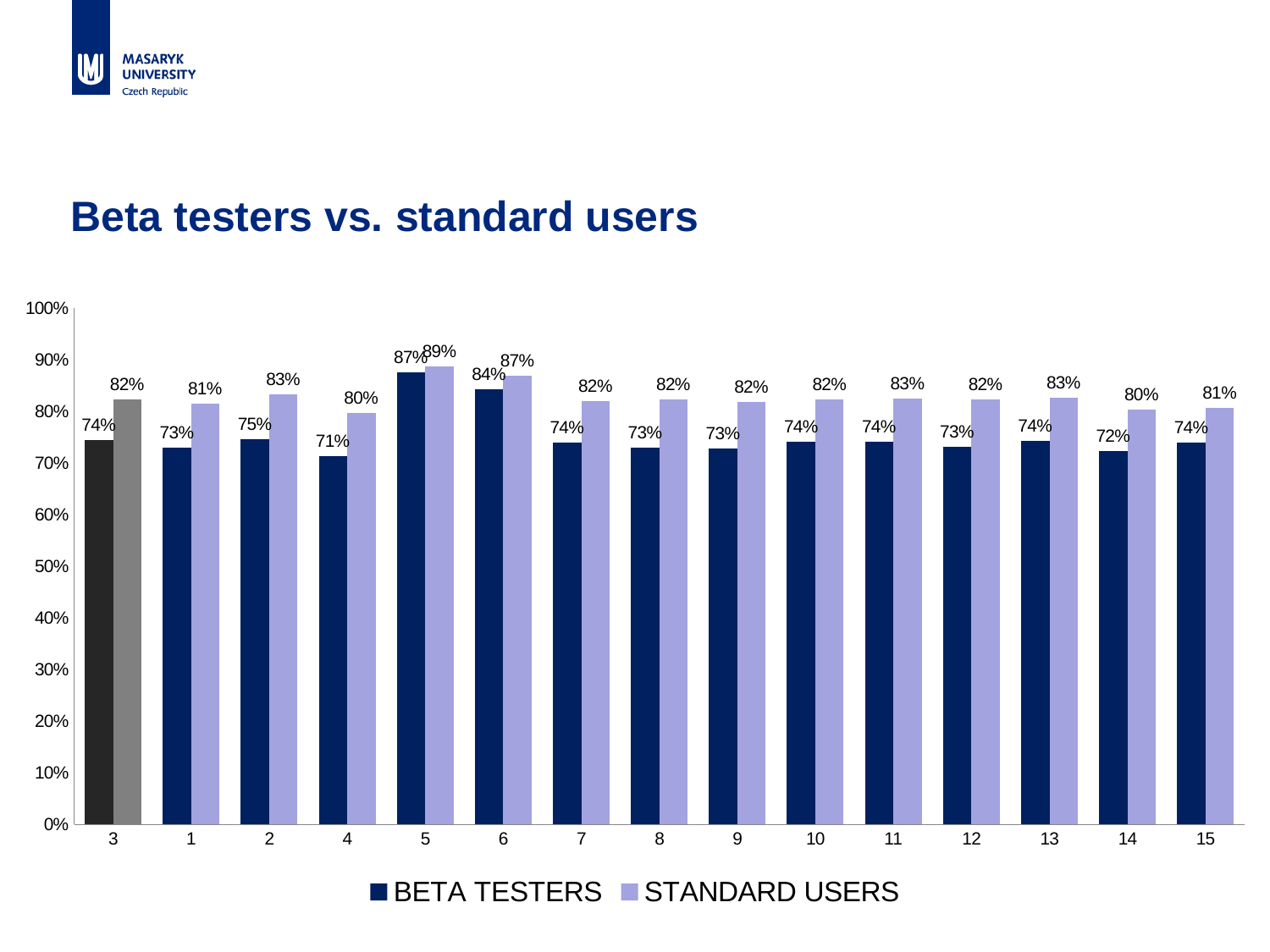
How many categories are shown on the x axis? 15 What is the title of the chart? Beta testers vs. standard users What type of chart is shown on the slide? bar chart Which category has the lowest BETA TESTERS value? 4 What is the BETA TESTERS value for category 5? 87% What is the BETA TESTERS value for category 14? 72% What is the STANDARD USERS value for category 4? 80% How many series does the legend list? 2 Which is larger for category 6, the BETA TESTERS value or the STANDARD USERS value? STANDARD USERS Is the STANDARD USERS value for category 5 greater or less than 80%? greater What is the difference between the STANDARD USERS and BETA TESTERS values for category 3? 8% Which category has the highest BETA TESTERS value? 5